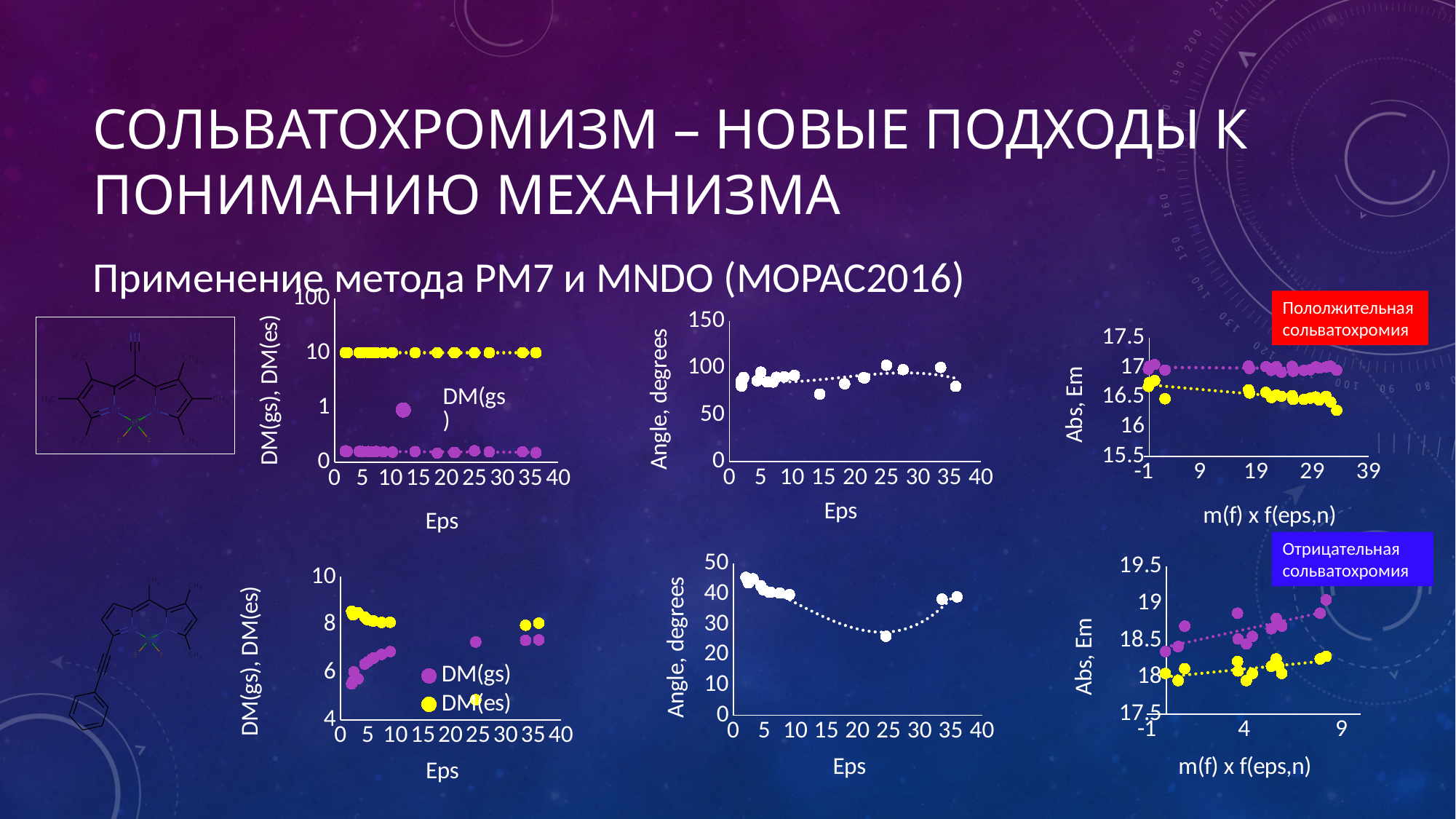
In the bottom-left chart (DM(gs), DM(es) vs Eps), which series has the higher values, DM(gs) or DM(es)? DM(es) In the bottom-middle chart (Angle, degrees vs Eps), is the angle value at Eps 25 greater or less than 30? less In the top-right chart (Положительная сольватохромия), which series has the higher values, the magenta or the yellow one? magenta In the top-left chart (DM(gs), DM(es) vs Eps), are the magenta DM(gs) values greater or less than 1? less What kind of chart is the top-left chart (DM(gs), DM(es) vs Eps)? scatter chart In the bottom-middle chart (Angle, degrees vs Eps), do the angle values rise or fall as Eps increases from 0 to 25? fall How many series does the legend of the bottom-left chart (DM(gs), DM(es) vs Eps) list? 2 In the bottom-right chart (Отрицательная сольватохромия), do the magenta values rise or fall as m(f) x f(eps,n) increases? rise What is the x-axis label of the top-right chart (Положительная сольватохромия)? m(f) x f(eps,n) In the top-middle chart (Angle, degrees vs Eps), are the plotted angle values greater or less than 50? greater